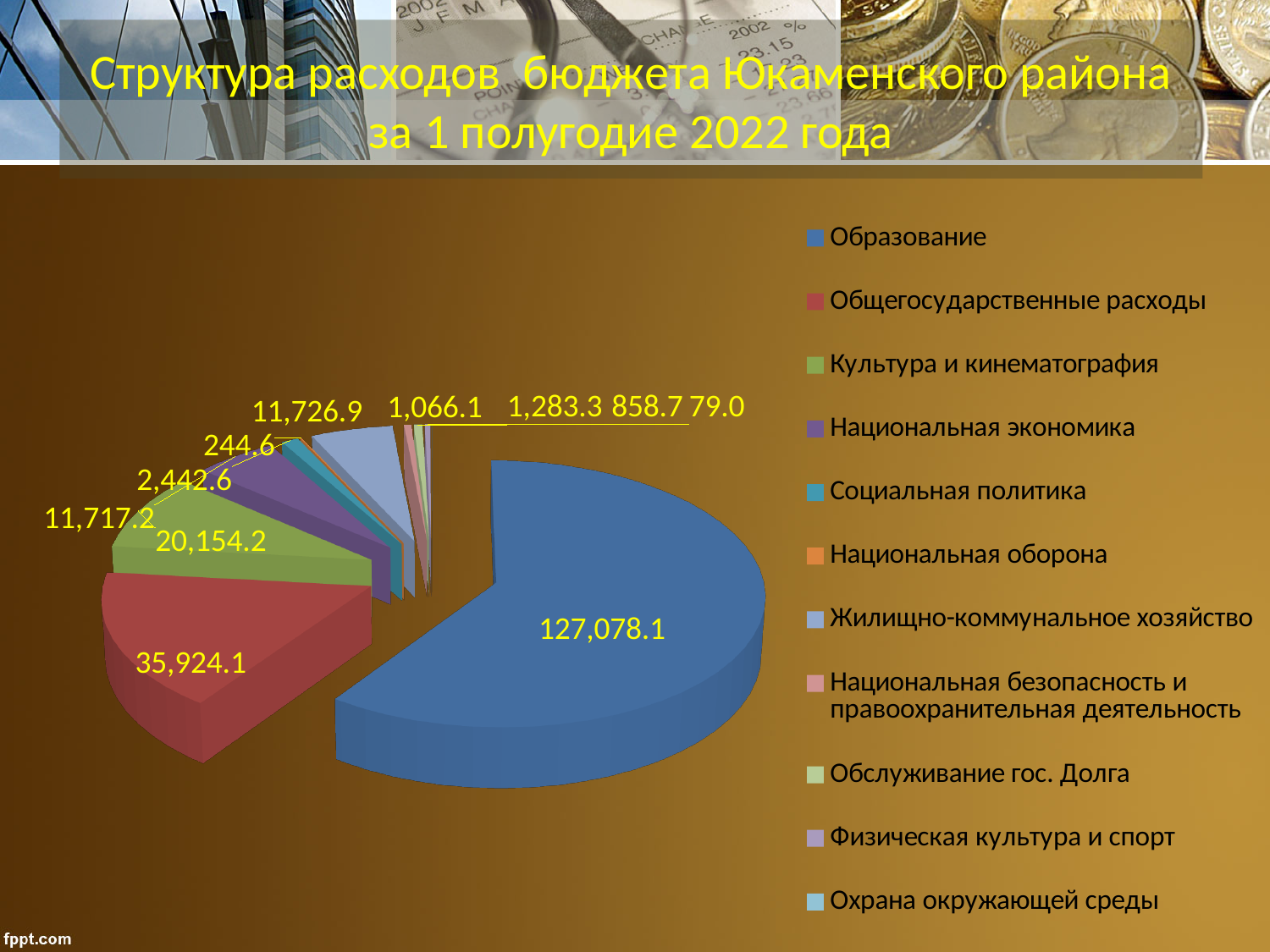
What is the title of the slide? Структура расходов бюджета Юкаменского района за 1 полугодие 2022 года What is the value shown for Общегосударственные расходы? 35,924.1 Which category has the largest slice of the pie? Образование What is the difference between the values for Образование and Общегосударственные расходы? 91,154.0 What is the value shown for Жилищно-коммунальное хозяйство? 11,726.9 Which is larger, the value for Образование or the value for Общегосударственные расходы? Образование What type of chart is shown on the slide? pie chart What is the value shown for Образование? 127,078.1 What is the value shown for Культура и кинематография? 20,154.2 What is the smallest value labelled on the pie chart? 79.0 What colour is the slice for Образование? blue How many categories does the legend list? 11